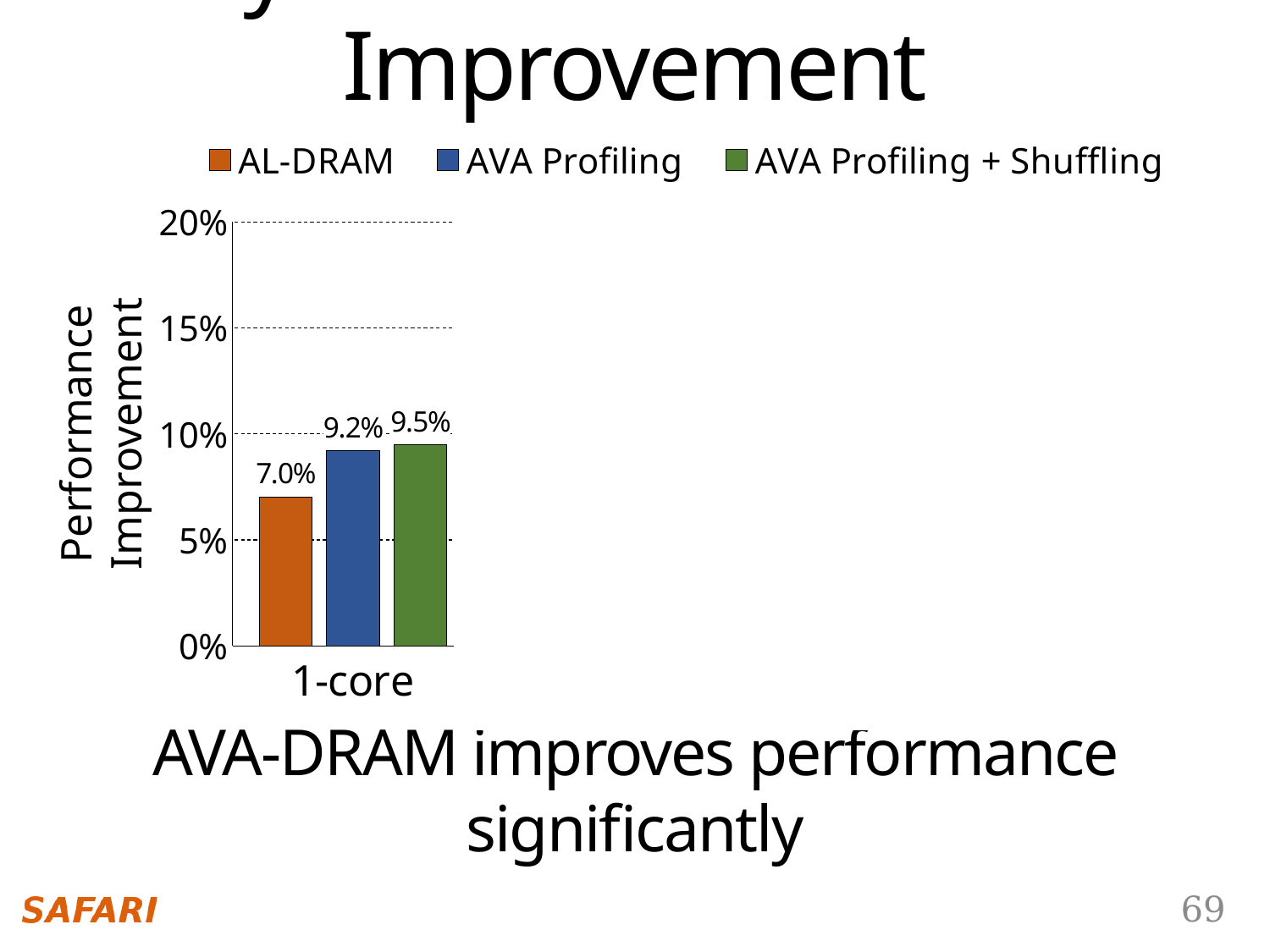
What is the difference in performance improvement between AVA Profiling + Shuffling and AL-DRAM? 2.5% What is the performance improvement for AVA Profiling on 1-core? 9.2% What is the difference in performance improvement between AVA Profiling and AL-DRAM? 2.2% What is the performance improvement for AL-DRAM on 1-core? 7.0% What kind of chart is shown on the slide? bar chart What is the performance improvement for AVA Profiling + Shuffling on 1-core? 9.5% Which series has the highest performance improvement for 1-core? AVA Profiling + Shuffling Which series has the lowest performance improvement for 1-core? AL-DRAM Is the performance improvement for AL-DRAM greater or less than 10%? less What is the label of the category on the x axis? 1-core How many series does the legend list? 3 Which has a larger performance improvement, AL-DRAM or AVA Profiling? AVA Profiling